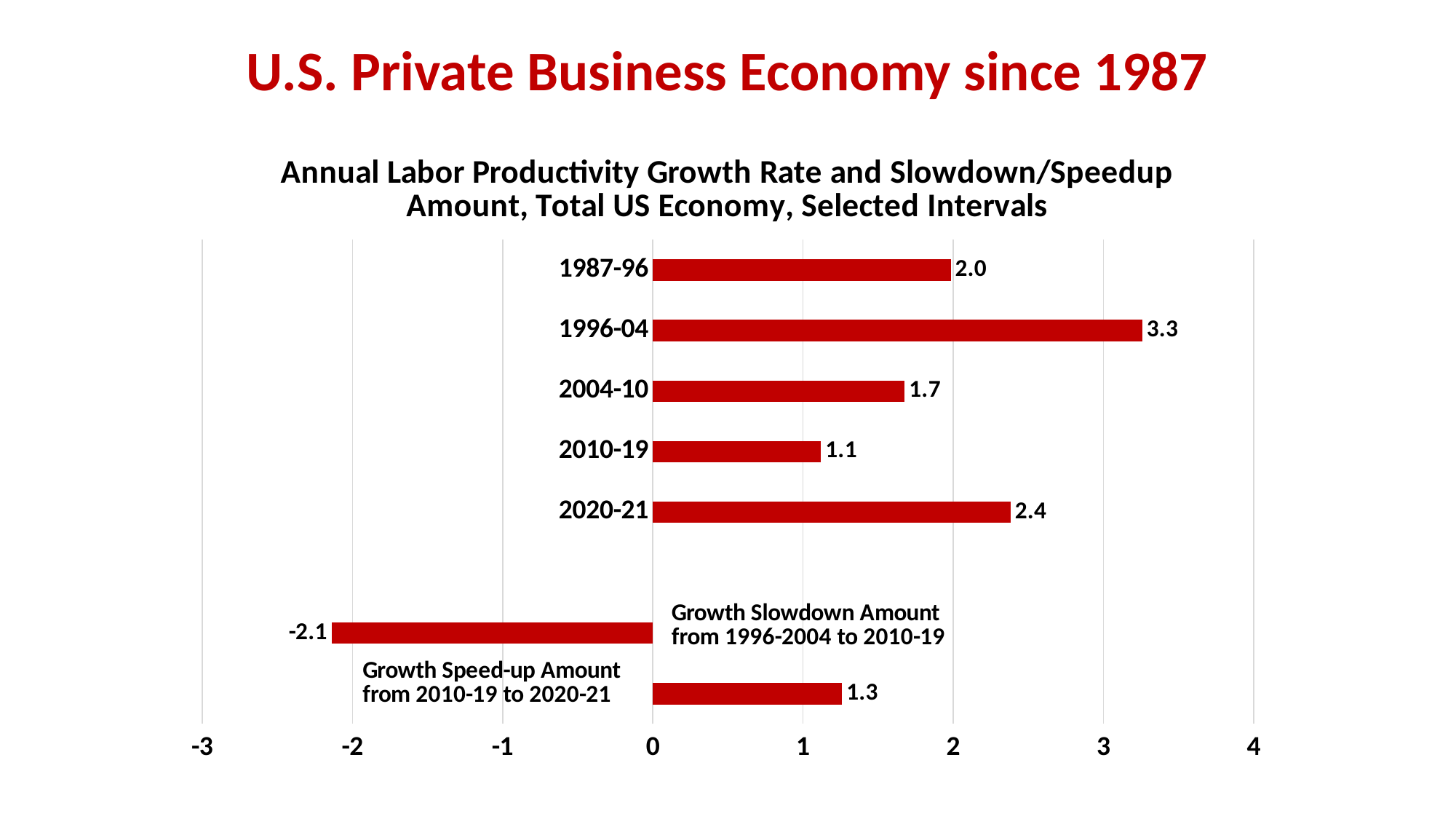
Which interval has the highest annual labor productivity growth rate? 1996-04 What is the title of the chart? Annual Labor Productivity Growth Rate and Slowdown/Speedup Amount, Total US Economy, Selected Intervals Which of the five time intervals has the lowest growth rate? 2010-19 What is the Growth Slowdown Amount from 1996-2004 to 2010-19? -2.1 What is the annual labor productivity growth rate for 1996-04? 3.3 How many bars are plotted on the chart? 7 What is the difference between the growth rates for 1996-04 and 2010-19? 2.2 What is the Growth Speed-up Amount from 2010-19 to 2020-21? 1.3 What is the annual labor productivity growth rate for 2010-19? 1.1 What is the value shown for 2020-21? 2.4 Which is larger, the growth rate for 1987-96 or for 2004-10? 1987-96 What kind of chart is shown on the slide? Bar chart